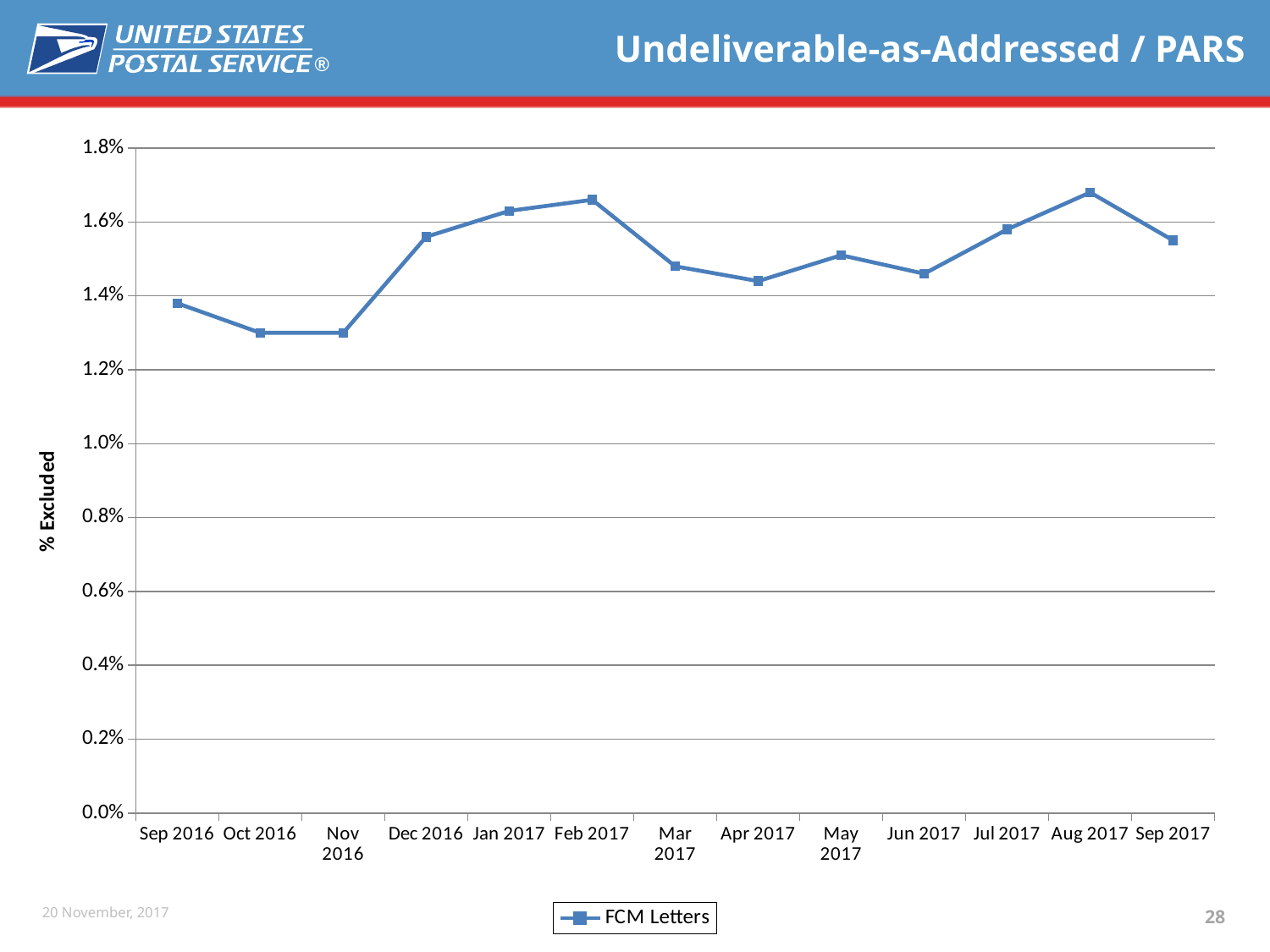
Is the value for Dec 2016 greater or less than 1.4%? greater Is the value for Sep 2016 greater or less than 1.4%? less Which is larger, the value for Feb 2017 or the value for Mar 2017? Feb 2017 How many months are plotted on the x axis? 13 How many series does the legend list? 1 What kind of chart is shown on the slide? line chart Which is larger, the value for Nov 2016 or the value for Dec 2016? Dec 2016 What is the label on the y axis? % Excluded Is the value for Aug 2017 greater or less than 1.6%? greater Do the values rise or fall from Nov 2016 to Feb 2017? rise